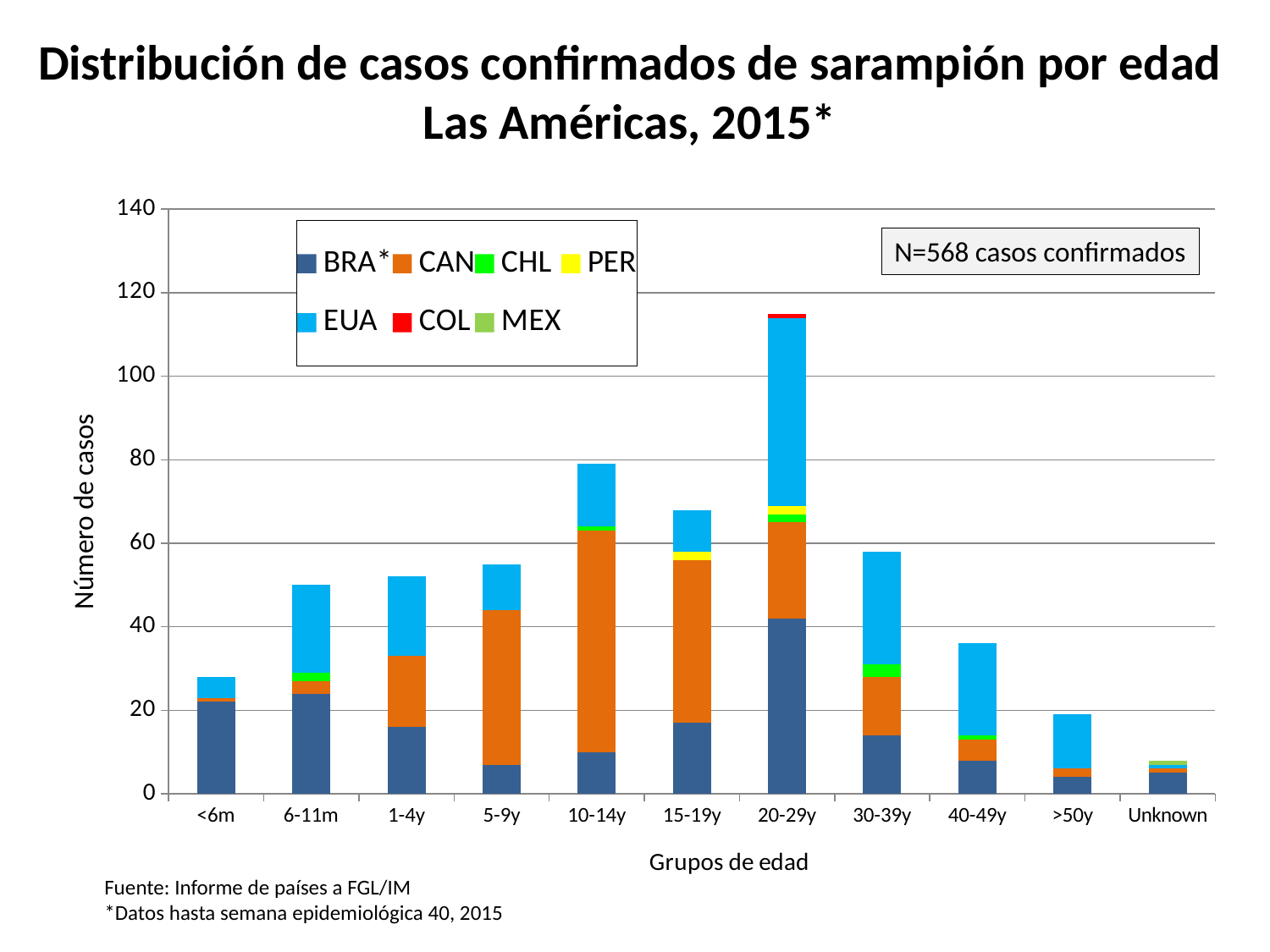
Which has a larger total, the 10-14y group or the 15-19y group? 10-14y Which age group has the lowest total number of cases? Unknown Is the total for the <6m age group greater or less than 20? greater Is the total for the 10-14y age group greater or less than 60? greater Which has a larger total, the 40-49y group or the >50y group? 40-49y Which age group has the highest total number of cases? 20-29y What kind of chart is shown on the slide? Stacked bar chart How many age groups are shown on the x axis? 11 According to the text box on the chart, how many confirmed cases are there in total? N=568 casos confirmados Is the total for the 20-29y age group greater or less than 100? greater How many series does the legend list? 7